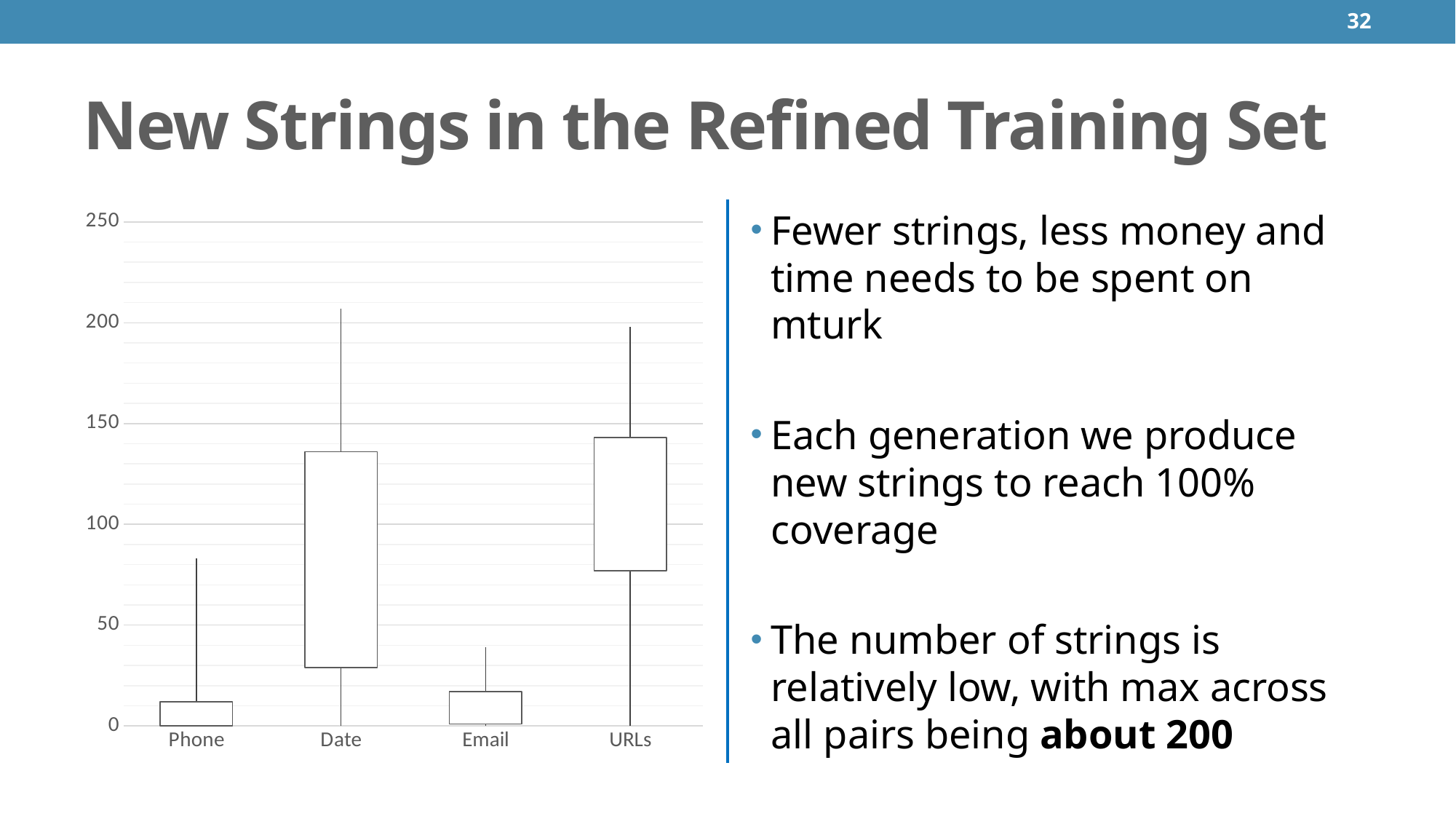
Is the top of the box for Date greater or less than 100? greater Is the top of the upper whisker for Phone greater or less than 100? less Which has the higher upper whisker, Phone or Email? Phone What is the highest tick value shown on the y axis of the chart? 250 Which category has the taller box, Date or Email? Date How many categories are shown on the x axis of the chart? 4 Is the bottom of the box for URLs greater or less than 50? greater What kind of chart is shown on the slide? Box-and-whisker plot Which category has the lowest upper whisker in the chart? Email